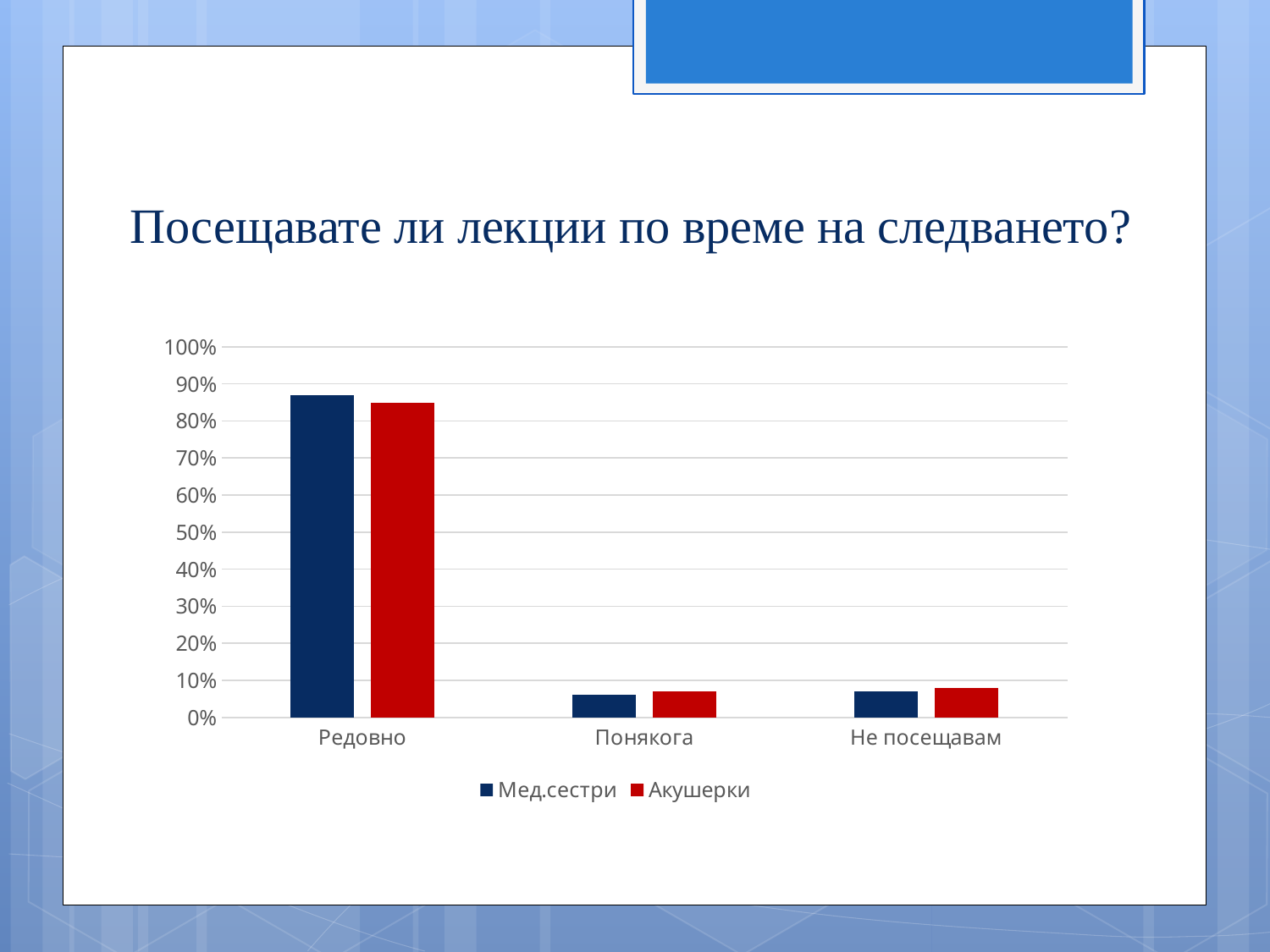
Is the value for Мед.сестри in Понякога greater or less than 10%? less What is the title of the chart? Посещавате ли лекции по време на следването? Which category has the highest value for Акушерки? Редовно For Акушерки, which is larger: the value for Редовно or the value for Понякога? Редовно What kind of chart is shown on the slide? bar chart Which category has the highest value for Мед.сестри? Редовно How many series does the legend list? 2 Which colour represents the Акушерки series in the chart? red Is the value for Акушерки in Редовно greater or less than 80%? greater Is the value for Мед.сестри in Редовно greater or less than 80%? greater How many categories are shown on the x axis of the chart? 3